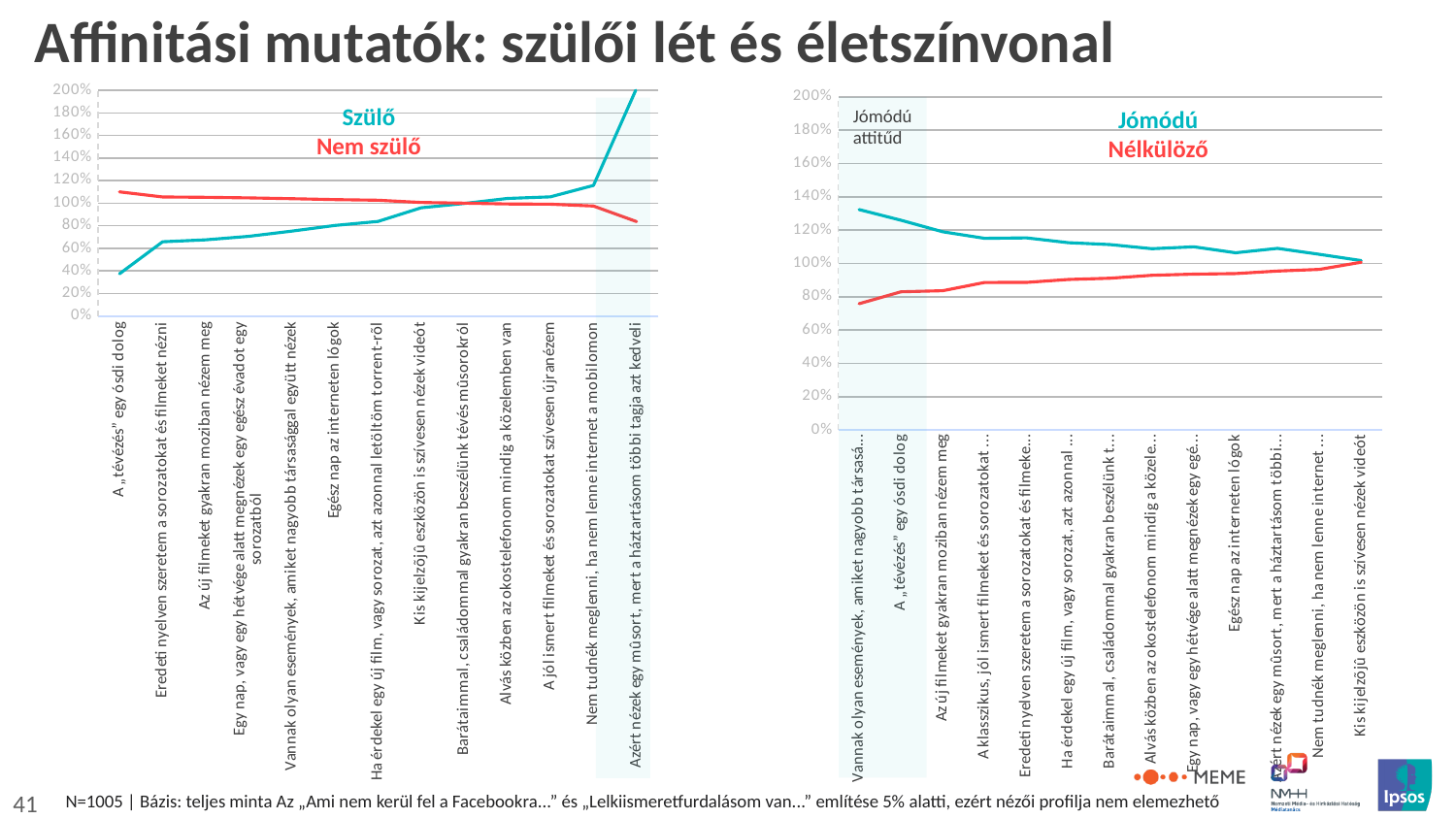
In the right chart, does the Nélkülöző line rise or fall from left to right along the x axis? rise In the left chart, which series has the larger value for "A „tévézés” egy ósdi dolog", Szülő or Nem szülő? Nem szülő In the left chart, does the Nem szülő line rise or fall from left to right along the x axis? fall In the left chart, which category has the highest value for the Szülő series? Azért nézek egy műsort, mert a háztartásom többi tagja azt kedveli In the left chart, is the Szülő value for "A „tévézés” egy ósdi dolog" greater or less than 60%? less In the left chart, is the Szülő value for "Azért nézek egy műsort, mert a háztartásom többi tagja azt kedveli" greater or less than 180%? greater In the right chart, which category has the highest value for the Jómódú series? Vannak olyan események, amiket nagyobb társasá… What type of chart is the left chart (Szülő / Nem szülő)? line chart How many categories are plotted along the x axis of the left chart? 13 In the right chart, is the Nélkülöző value for "Vannak olyan események, amiket nagyobb társasá…" greater or less than 100%? less How many series does the legend of the right chart list? 2 In the left chart, which category has the lowest value for the Szülő series? A „tévézés” egy ósdi dolog